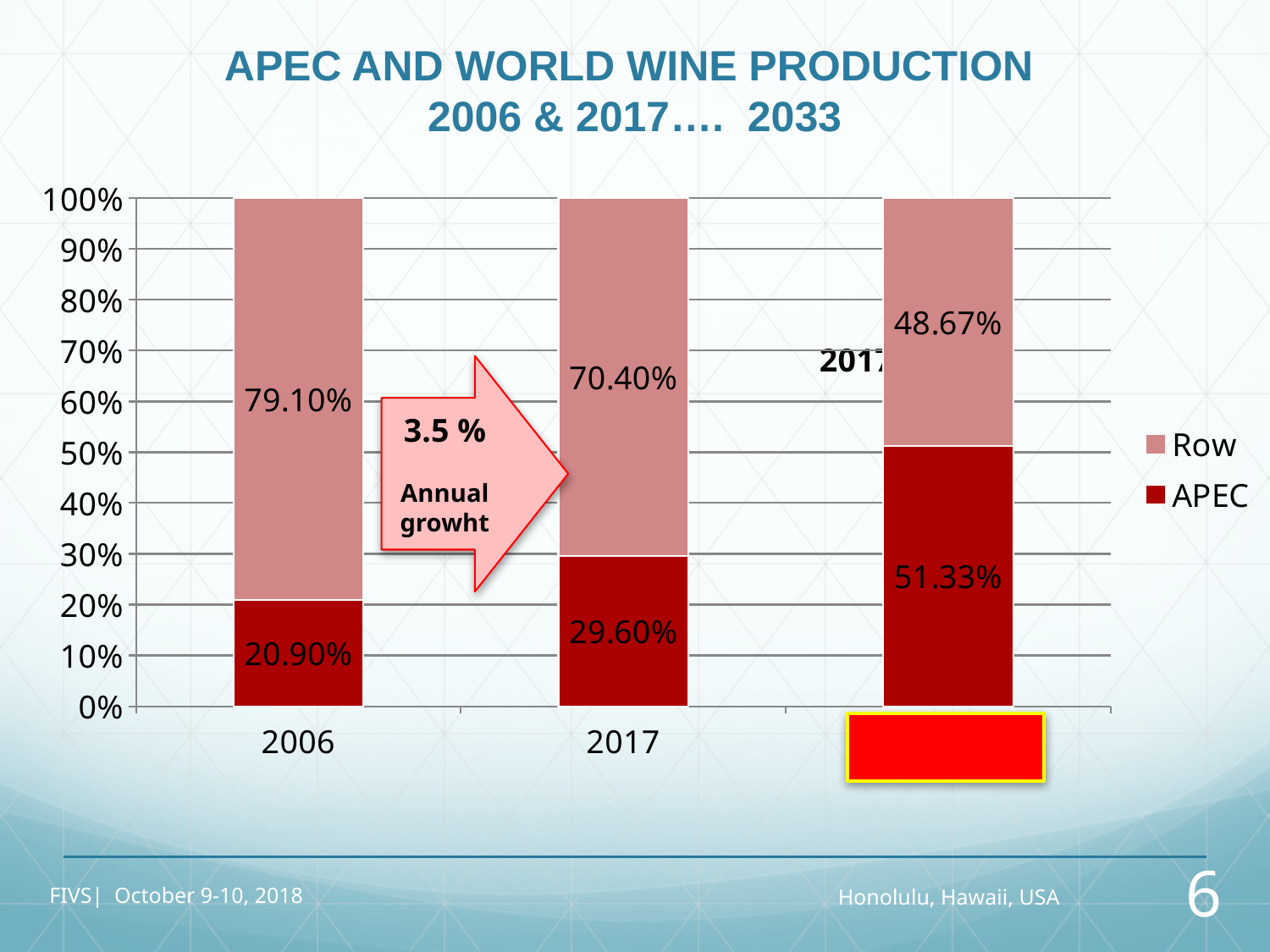
How many series does the legend list? 2 In 2017, which series has the larger share, APEC or Row? Row What is the Row share of wine production in 2006? 79.10% Does the APEC share rise or fall from 2006 to 2017? Rises What is the Row share of wine production in 2017? 70.40% What is the APEC value shown on the rightmost bar of the chart? 51.33% By how many percentage points does the Row share exceed the APEC share in 2006? 58.20% What kind of chart is shown on the slide? Stacked bar chart What is the APEC share of wine production in 2017? 29.60% What is the APEC share of wine production in 2006? 20.90% What is the total of the stacked bar for 2017? 100% By how much did the APEC share increase from 2006 to 2017? 8.70%